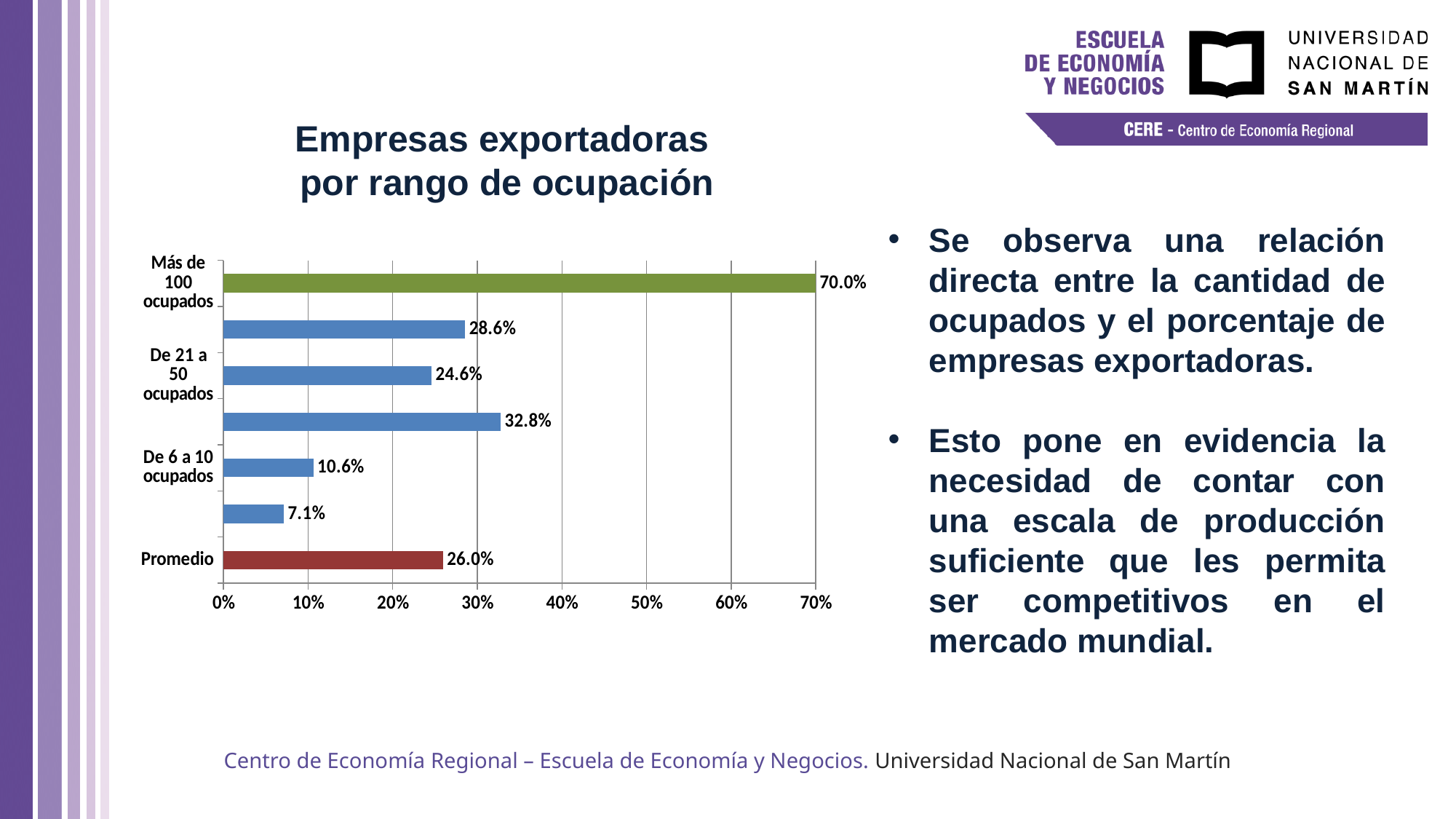
What is the value for 'De 21 a 50 ocupados'? 24.6% Which is larger, the value for 'De 21 a 50 ocupados' or 'De 6 a 10 ocupados'? De 21 a 50 ocupados What is the lowest value shown on the chart? 7.1% What is the value for 'Más de 100 ocupados'? 70.0% What colour is the 'Promedio' bar? Red What is the value for 'De 6 a 10 ocupados'? 10.6% What is the difference between the value for 'Más de 100 ocupados' and 'Promedio'? 44.0 percentage points How many bars are plotted on the chart? 7 What is the title of the chart? Empresas exportadoras por rango de ocupación Which category has the highest value? Más de 100 ocupados What is the value for 'Promedio'? 26.0% What type of chart is shown on the slide? Bar chart